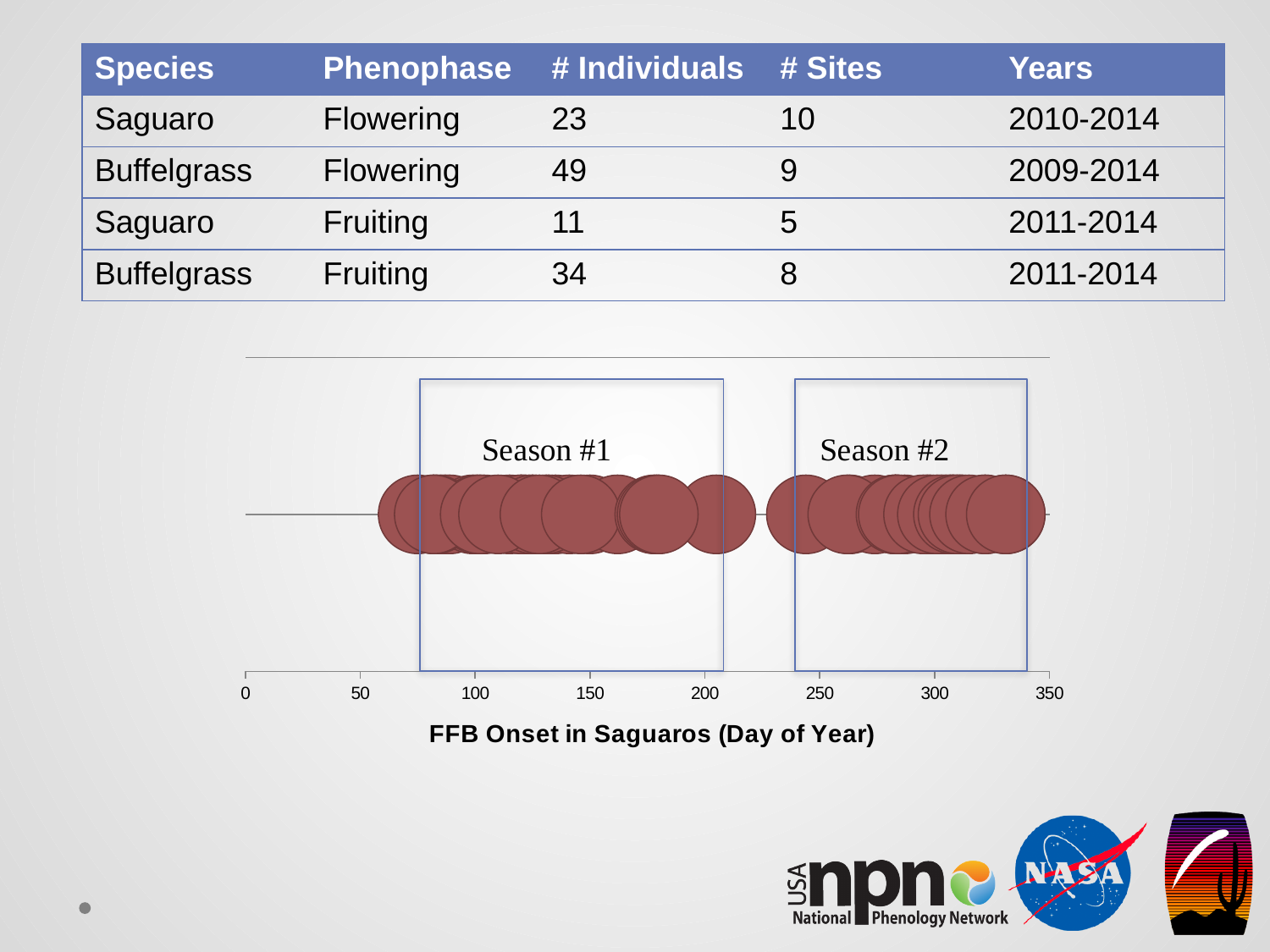
Is the latest Season #2 point greater or less than 300 on the day-of-year axis? greater Is the earliest Season #1 point greater or less than 100 on the day-of-year axis? less How many seasons are marked with boxes in the chart? 2 What is the lowest tick value shown on the x axis of the chart? 0 How many tick labels are shown on the x axis of the chart? 8 What is the highest tick value shown on the x axis of the chart? 350 What is the title of the x axis of the chart? FFB Onset in Saguaros (Day of Year) What kind of chart is shown on the slide? scatter (dot) plot Are the Season #2 points greater or less than 200 on the day-of-year axis? greater Which season's points lie at higher day-of-year values, Season #1 or Season #2? Season #2 What are the labels of the two boxed groups of points in the chart? Season #1 and Season #2